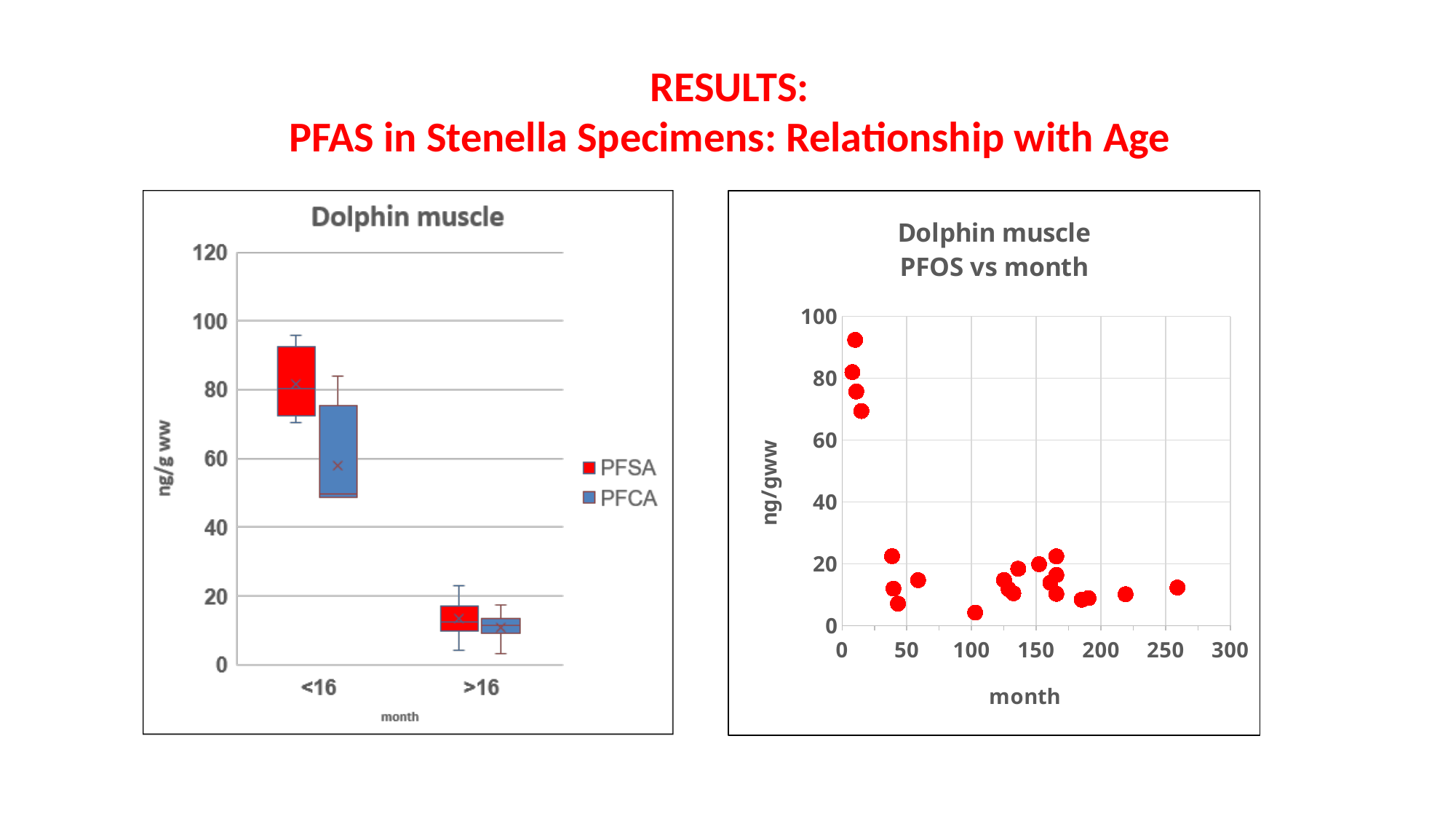
What is the y-axis label of the right "Dolphin muscle PFOS vs month" chart? ng/gww In the left "Dolphin muscle" chart, is the PFSA value for the <16 month group greater or less than 60? greater In the left "Dolphin muscle" chart, is the PFSA value for the >16 month group greater or less than 40? less In the left "Dolphin muscle" chart, how many series does the legend list? 2 In the left "Dolphin muscle" chart, how many age categories are shown on the x axis? 2 In the left "Dolphin muscle" chart, do PFSA values rise or fall from the <16 group to the >16 group? fall In the right "Dolphin muscle PFOS vs month" chart, is the highest PFOS value greater or less than 80? greater What kind of chart is the left chart titled "Dolphin muscle"? box plot What kind of chart is the right chart titled "Dolphin muscle PFOS vs month"? scatter plot In the right "Dolphin muscle PFOS vs month" chart, do PFOS values generally rise or fall as month increases? fall In the left "Dolphin muscle" chart, which series has the higher values for the <16 month group, PFSA or PFCA? PFSA